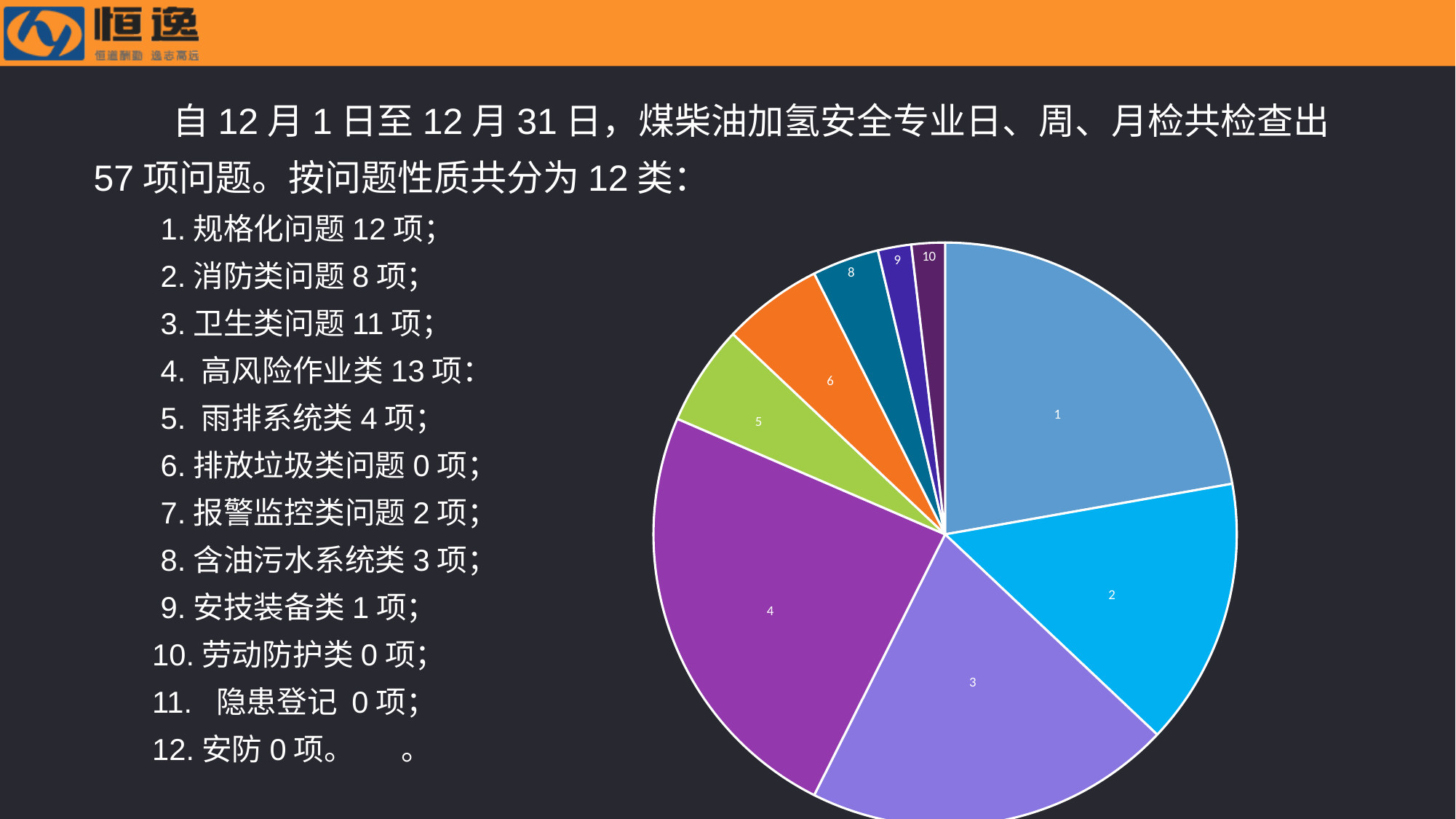
How many labelled slices does the pie chart have? 9 Which is larger in the pie chart, slice 2 or slice 9? slice 2 Which is larger in the pie chart, slice 1 or slice 2? slice 1 Which is larger in the pie chart, slice 5 or slice 8? slice 5 What kind of chart is shown on the slide? pie chart What colour is slice 4 in the pie chart? purple Which slice of the pie chart is the largest? 4 What colour is slice 6 in the pie chart? orange